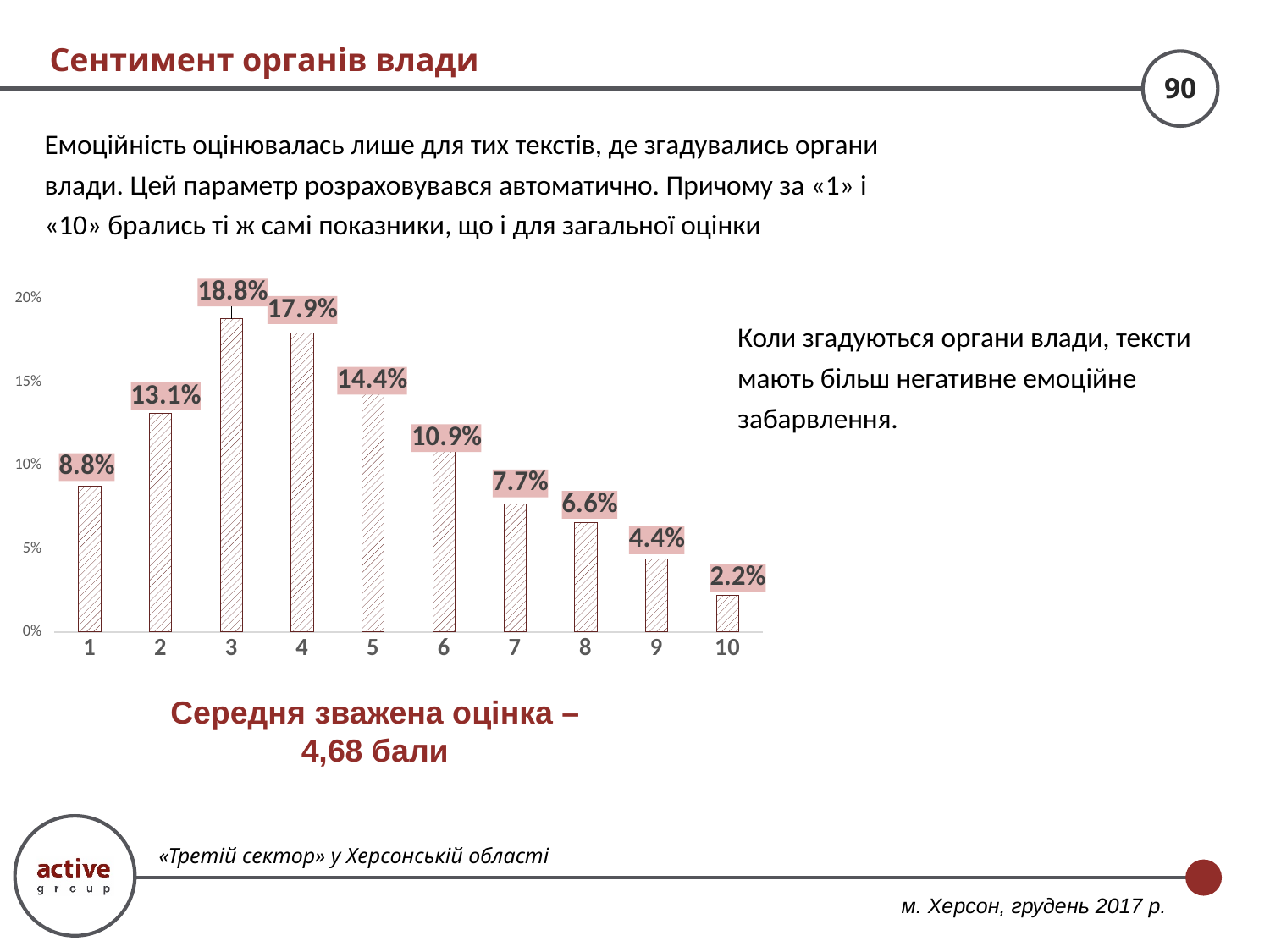
Which category has the highest value? 3 What is the value for category 10? 2.2% Is the value for category 7 greater or less than 10%? less Which category has the lowest value? 10 What is the value for category 6? 10.9% Do the values rise or fall along the x axis from category 3 to category 10? fall What is the difference between the values for category 3 and category 4? 0.9% What kind of chart is shown on the slide? bar chart How many categories are shown on the x axis? 10 What is the difference between the values for category 1 and category 10? 6.6% What is the value for category 3? 18.8% Which is larger, the value for category 2 or the value for category 5? 5